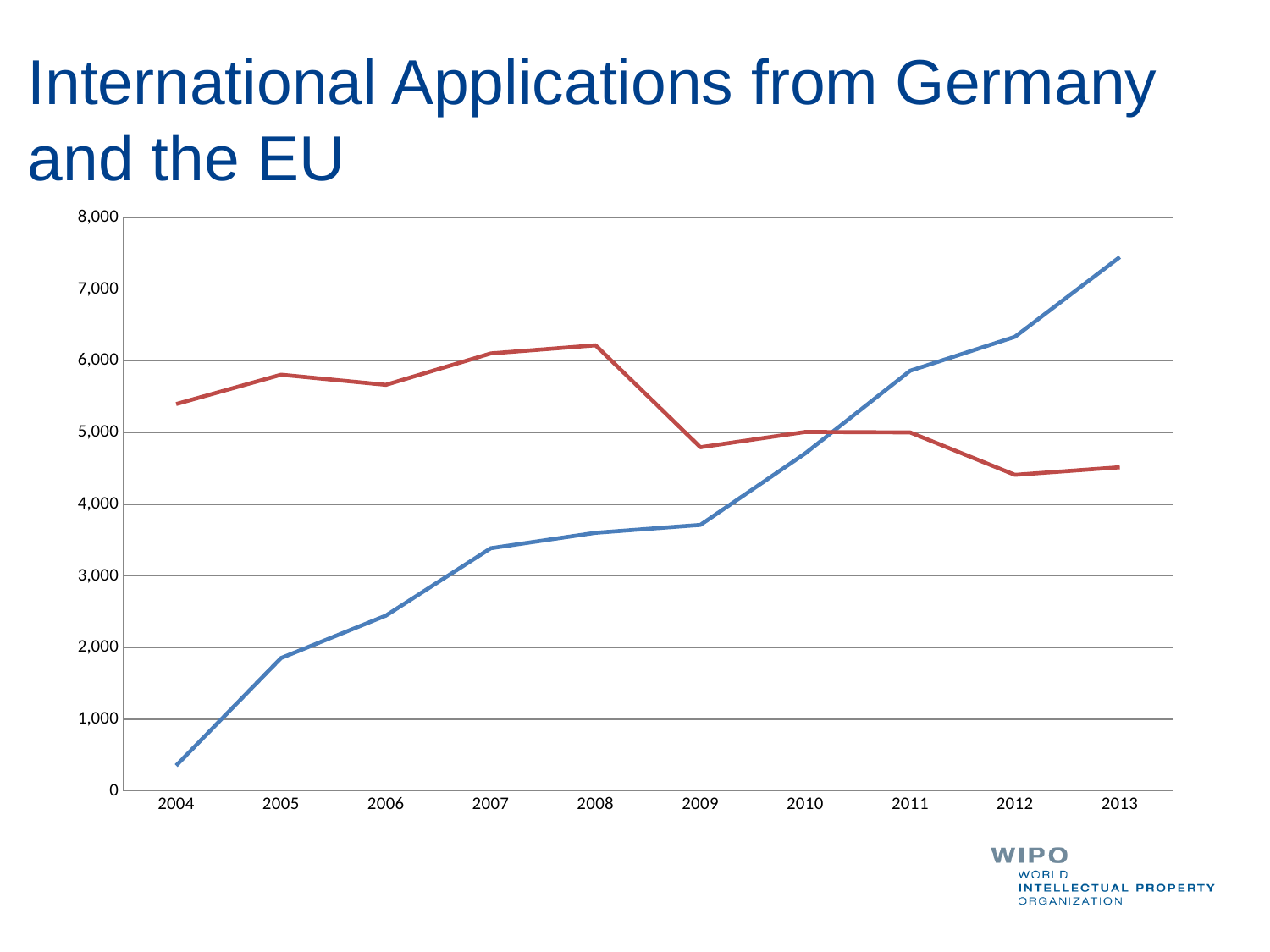
In 2004, which line has the higher value, the blue line or the red line? Red line In which year does the blue line have its lowest value? 2004 How many lines are plotted on the chart? 2 Is the value of the red line in 2008 greater or less than 6,000? greater What kind of chart is shown on the slide? Line chart Is the value of the blue line in 2013 greater or less than 7,000? greater Is the value of the red line in 2012 greater or less than 5,000? less In which year does the blue line reach its highest value? 2013 How many years are shown along the x axis of the chart? 10 What is the title of the slide containing the chart? International Applications from Germany and the EU